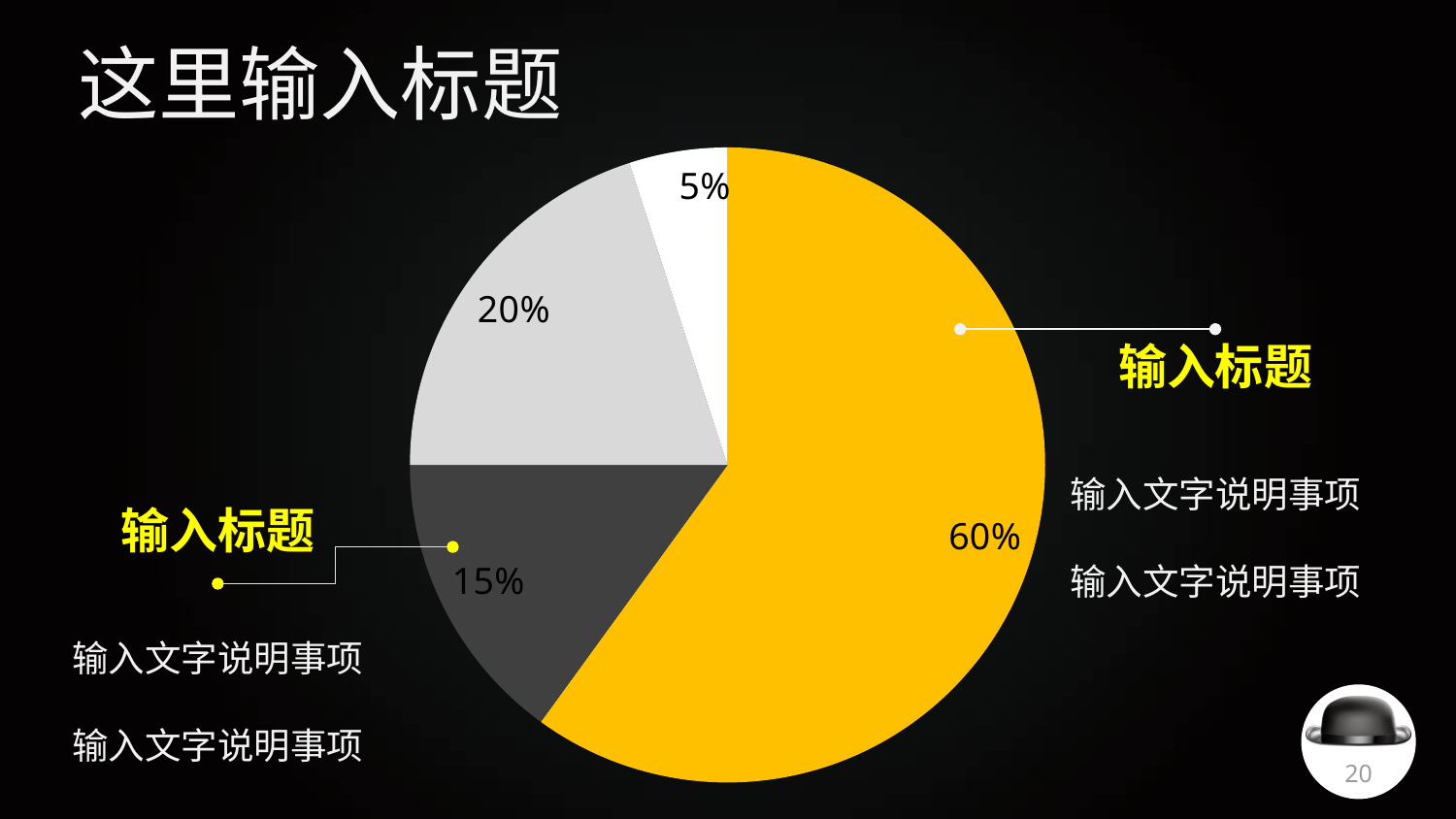
What is the combined share of the light gray and dark gray slices of the pie chart? 35% Which is larger in the pie chart, the light gray slice or the dark gray slice? the light gray slice Which slice of the pie chart is the largest? the yellow slice (60%) What percentage is shown on the dark gray slice of the pie chart? 15% How many slices does the pie chart have? 4 What percentage is shown on the light gray slice of the pie chart? 20% What percentage is shown on the white slice of the pie chart? 5% Which slice of the pie chart is the smallest? the white slice (5%) What percentage is shown on the yellow slice of the pie chart? 60% What kind of chart is shown on the slide? pie chart What is the difference between the yellow slice and the light gray slice of the pie chart? 40% What colour is the largest slice of the pie chart? yellow